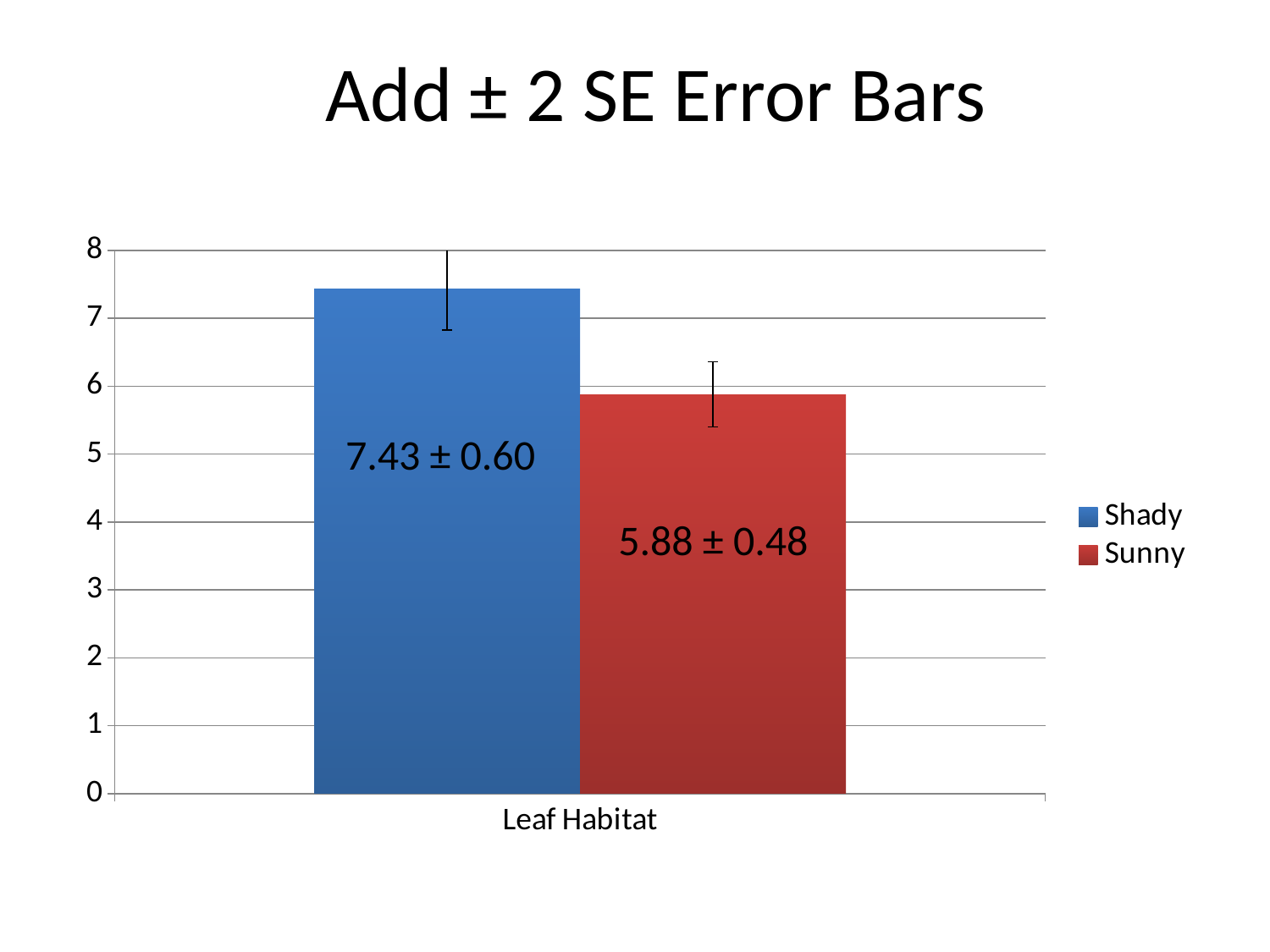
How many series does the legend list? 2 What is the value shown for the Shady series? 7.43 ± 0.60 What kind of chart is shown on the slide? bar chart What is the difference between the Shady mean (7.43) and the Sunny mean (5.88)? 1.55 What is the label on the x axis? Leaf Habitat What is the maximum value shown on the y axis? 8 What is the value shown for the Sunny series? 5.88 ± 0.48 Is the value for Shady greater or less than 7? greater Which series has the higher value, Shady or Sunny? Shady Is the value for Sunny greater or less than 6? less Which series has the lowest bar? Sunny What is the title of the slide? Add ± 2 SE Error Bars